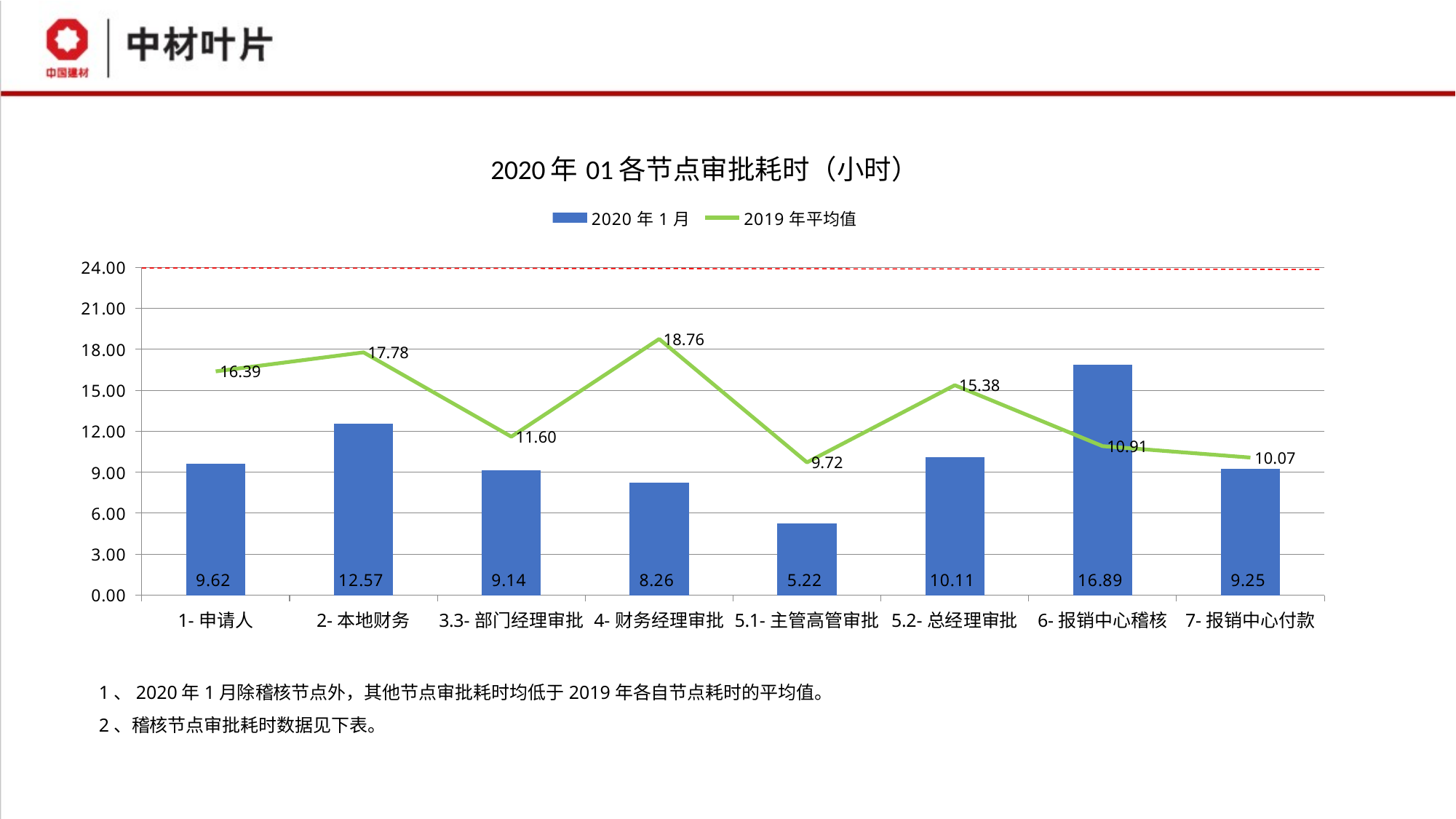
What kind of chart is this? Combined bar and line chart What colour is the 2019年平均值 line? Green Which category has the highest 2020年1月 value? 6-报销中心稽核 What is the 2020年1月 value for 2-本地财务? 12.57 How many series does the legend list? 2 How many categories are shown on the x axis? 8 Which category has the lowest 2019年平均值 value? 5.1-主管高管审批 For 6-报销中心稽核, which is larger: the 2020年1月 value or the 2019年平均值? 2020年1月 What is the 2020年1月 value for 5.1-主管高管审批? 5.22 What is the difference between the 2019年平均值 and the 2020年1月 value for 1-申请人? 6.77 What is the 2019年平均值 value for 4-财务经理审批? 18.76 What is the title of the chart? 2020年01各节点审批耗时（小时）